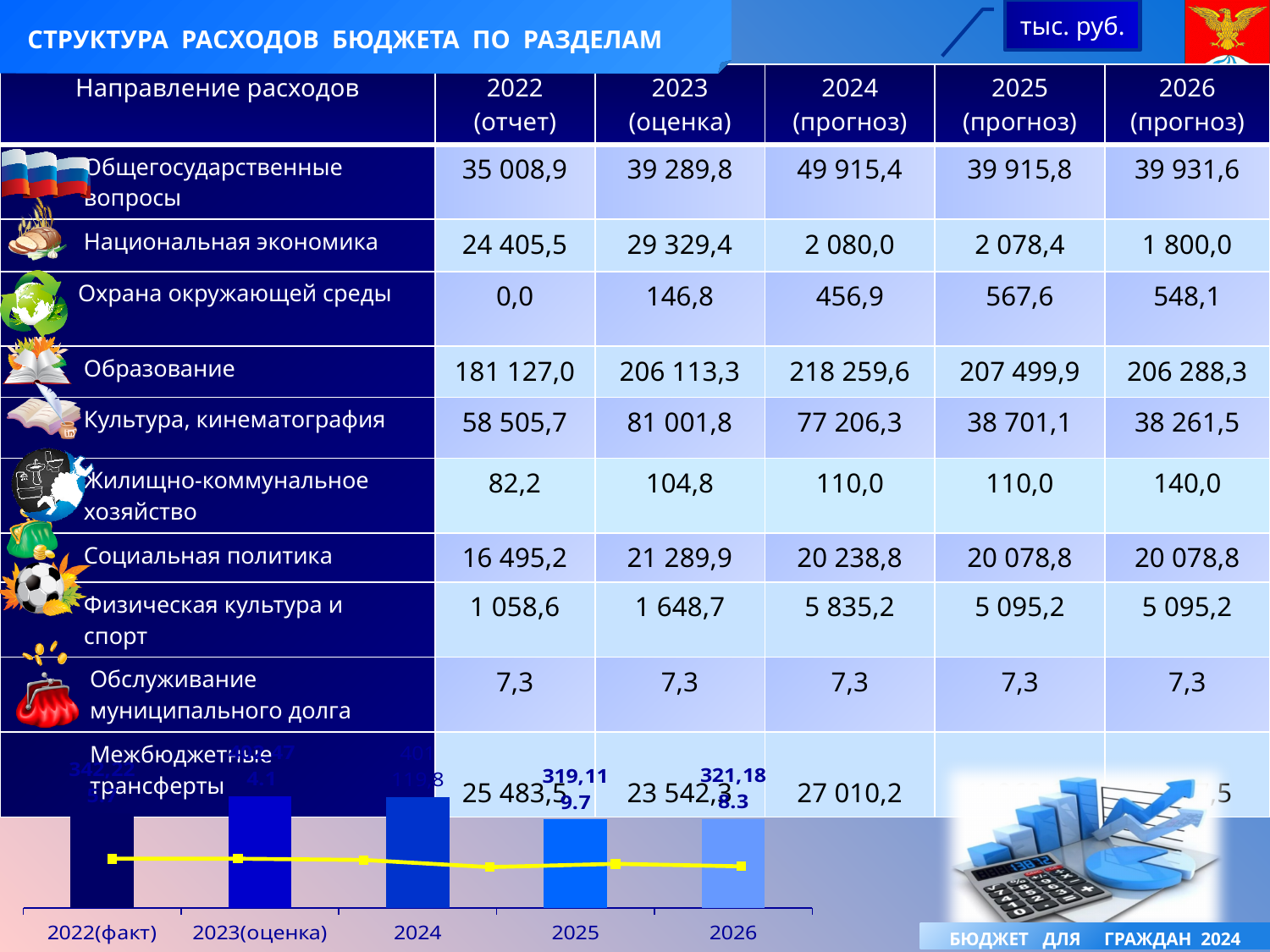
In the chart at the bottom of the slide, which is larger: the bar label for 2025 (319,11) or for 2026 (321,18)? 2026 How many categories (years) are shown on the x axis of the chart at the bottom of the slide? 5 In the chart at the bottom of the slide, which year's bar is labelled 321,18? 2026 In the chart at the bottom of the slide, which year's bar is labelled 319,11? 2025 What is the second category label on the x axis of the chart at the bottom of the slide? 2023(оценка) What is the last category label on the x axis of the chart at the bottom of the slide? 2026 What is the first category label on the x axis of the chart at the bottom of the slide? 2022(факт) What kind of chart is shown at the bottom of the slide? bar chart with a line